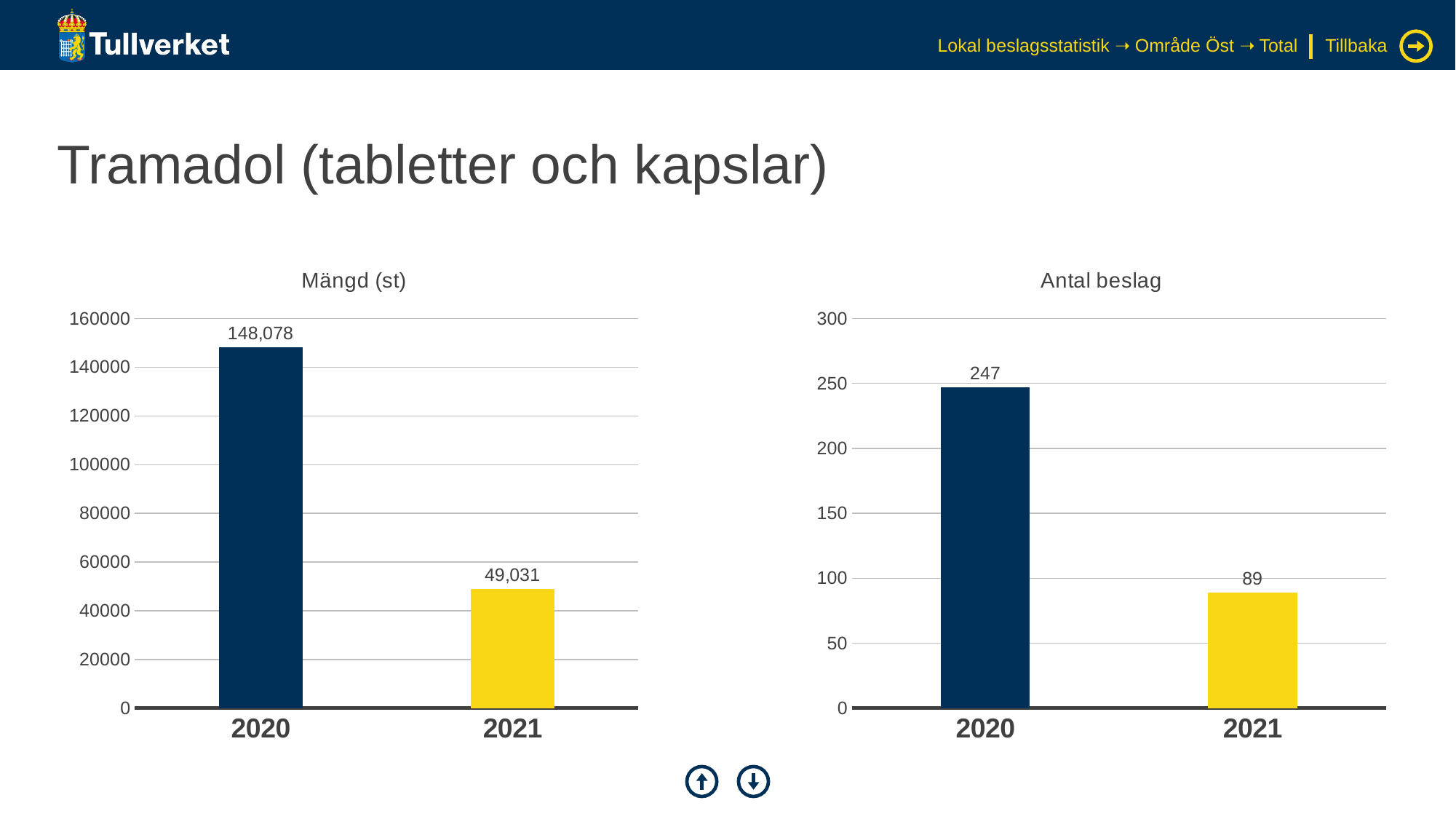
In the 'Mängd (st)' chart, what is the difference between the 2020 and 2021 values? 99,047 In the 'Antal beslag' chart, what is the difference between the 2020 and 2021 values? 158 In the 'Mängd (st)' chart, which year has the highest value? 2020 What kind of chart is the 'Antal beslag' chart? bar chart In the 'Antal beslag' chart, what is the value for 2021? 89 In the 'Antal beslag' chart, is the value for 2021 greater or less than 100? less In the 'Antal beslag' chart, which year has the lowest value? 2021 In the 'Mängd (st)' chart, do the values rise or fall from 2020 to 2021? fall In the 'Antal beslag' chart, what is the value for 2020? 247 In the 'Mängd (st)' chart, what is the value for 2021? 49,031 How many categories are shown on the x axis of the 'Mängd (st)' chart? 2 In the 'Mängd (st)' chart, what is the value for 2020? 148,078